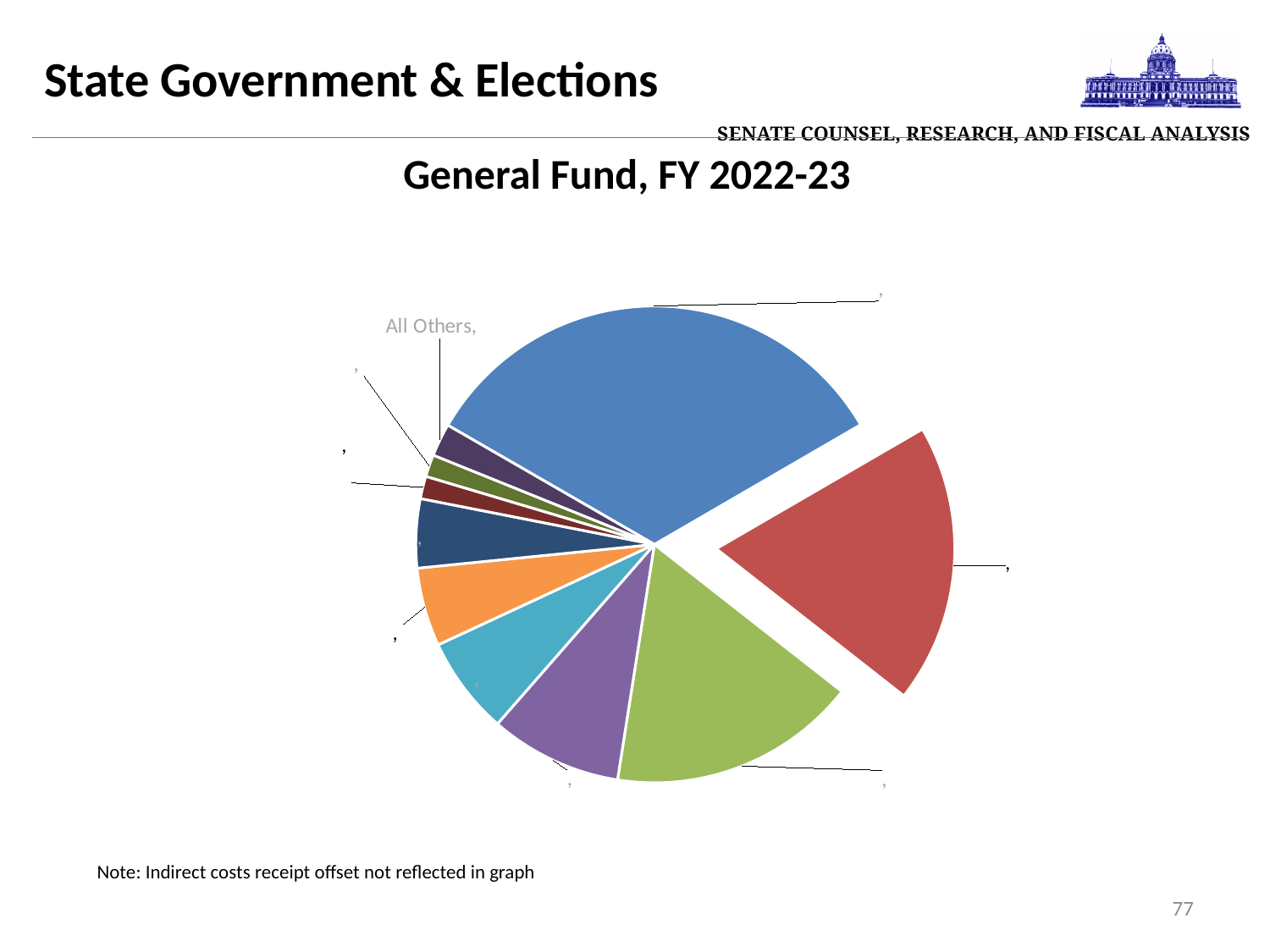
Which slice is pulled out (exploded) from the rest of the pie? the red slice How many slices does the pie chart have? 10 What note appears below the chart? Note: Indirect costs receipt offset not reflected in graph What is the title of the chart? General Fund, FY 2022-23 Is the 'All Others' slice larger or smaller than the largest (blue) slice of the pie? smaller What kind of chart is shown on the slide? pie chart